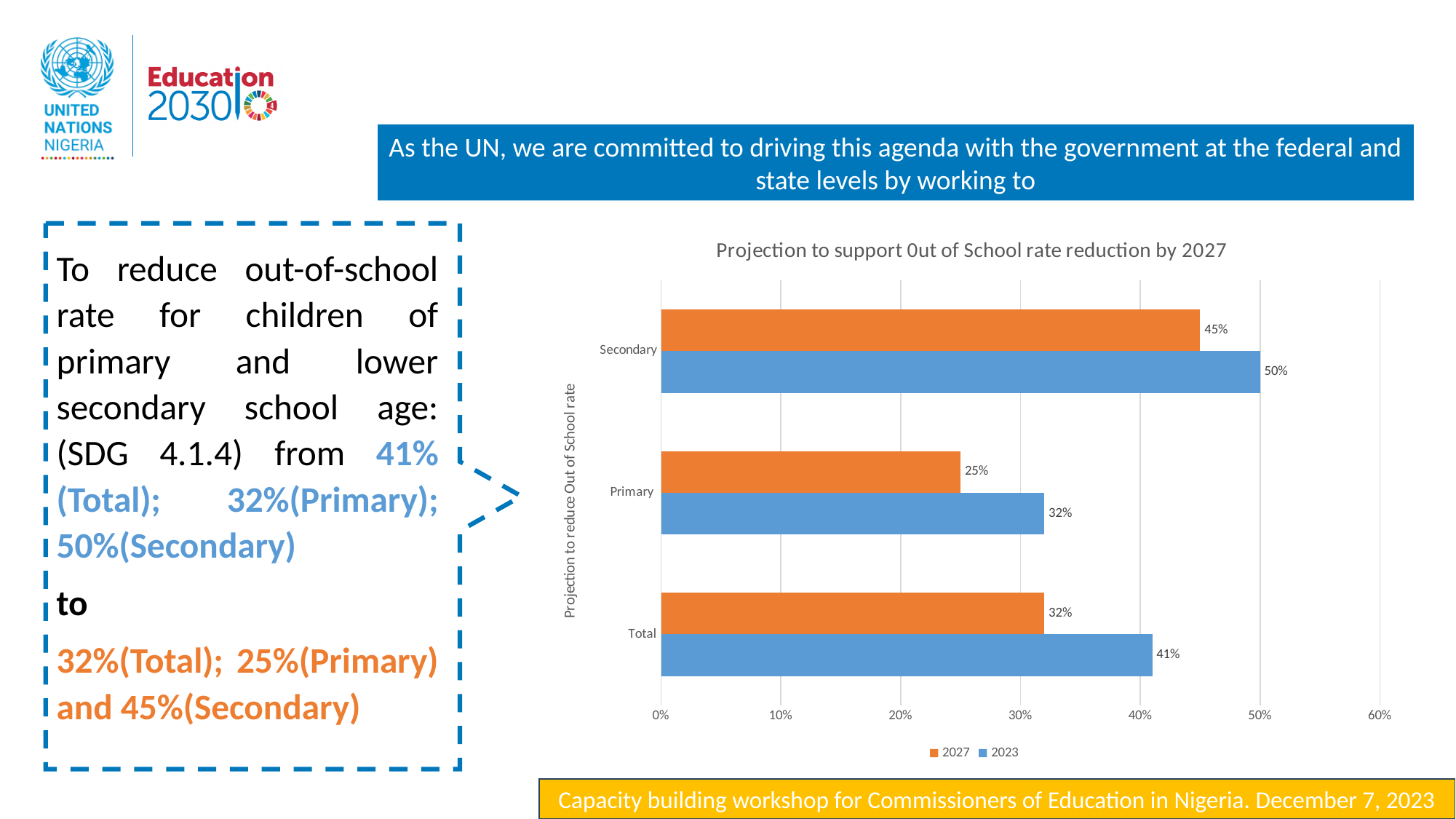
What is the 2023 value for Total? 41% What is the 2027 value for Total? 32% What is the difference between the 2023 and 2027 values for Total? 9% Which category has the lowest 2027 value? Primary What kind of chart is shown on the slide? Bar chart Which category has the highest 2023 value? Secondary How many categories are shown on the chart? 3 Which is larger, the 2023 value for Primary or the 2027 value for Primary? 2023 What is the 2027 value for Primary? 25% How many series does the legend list? 2 What is the 2023 value for Secondary? 50% What is the difference between the 2023 and 2027 values for Secondary? 5%